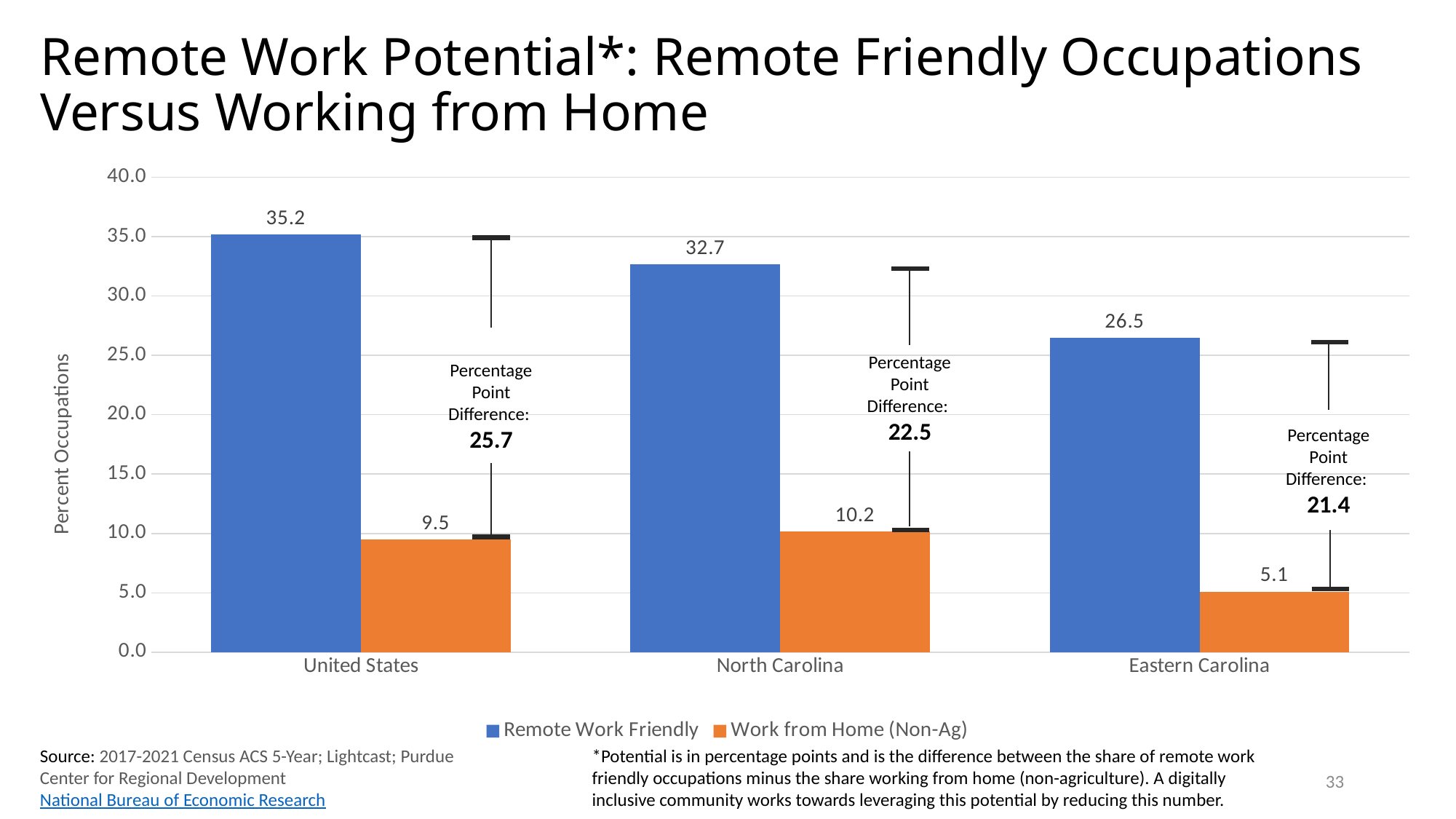
What is the difference between the Remote Work Friendly and Work from Home (Non-Ag) values for North Carolina? 22.5 What is the Remote Work Friendly value for the United States? 35.2 What is the Work from Home (Non-Ag) value for Eastern Carolina? 5.1 How many regions are shown on the x axis? 3 Which region has the lowest Work from Home (Non-Ag) value? Eastern Carolina What is the difference between the Remote Work Friendly values for the United States and Eastern Carolina? 8.7 What kind of chart is shown on the slide? bar chart How many series does the legend list? 2 Is the Remote Work Friendly value for Eastern Carolina greater or less than 30.0? less Which is larger, the Work from Home (Non-Ag) value for the United States or for North Carolina? North Carolina Which region has the highest Remote Work Friendly value? United States What is the Work from Home (Non-Ag) value for North Carolina? 10.2